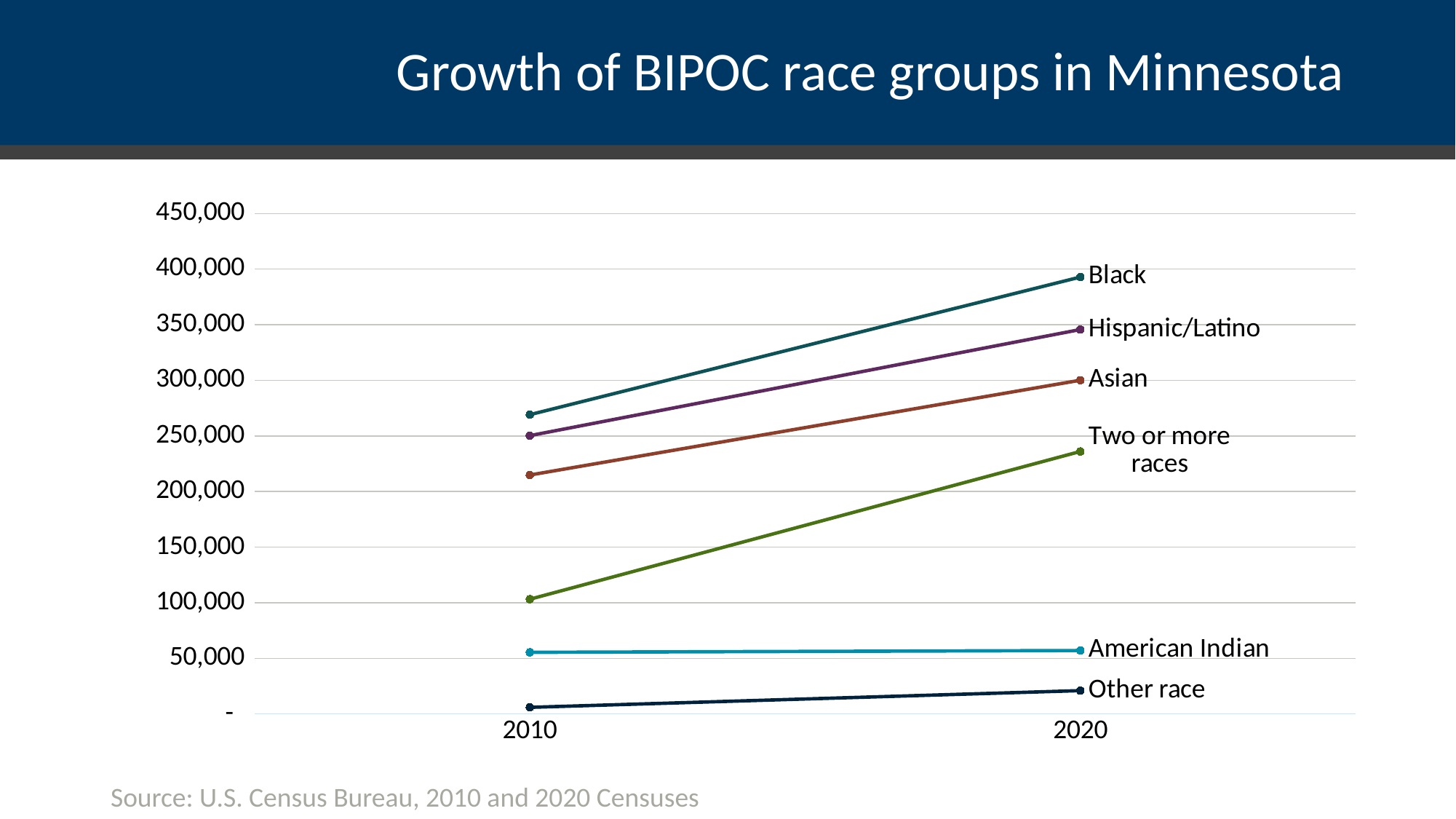
What is the title of the chart? Growth of BIPOC race groups in Minnesota What kind of chart is shown on the slide? line chart Does the value for Two or more races rise or fall from 2010 to 2020? rise Is the value for Black in 2020 greater or less than 350,000? greater Is the value for Other race in 2020 greater or less than 50,000? less Is the value for Asian in 2010 greater or less than 200,000? greater How many years are shown on the x axis? 2 Which is larger in 2020, the value for Black or the value for Hispanic/Latino? Black Which race group has the highest value in 2020? Black Which race group has the lowest value in 2020? Other race How many race groups are plotted as lines on the chart? 6